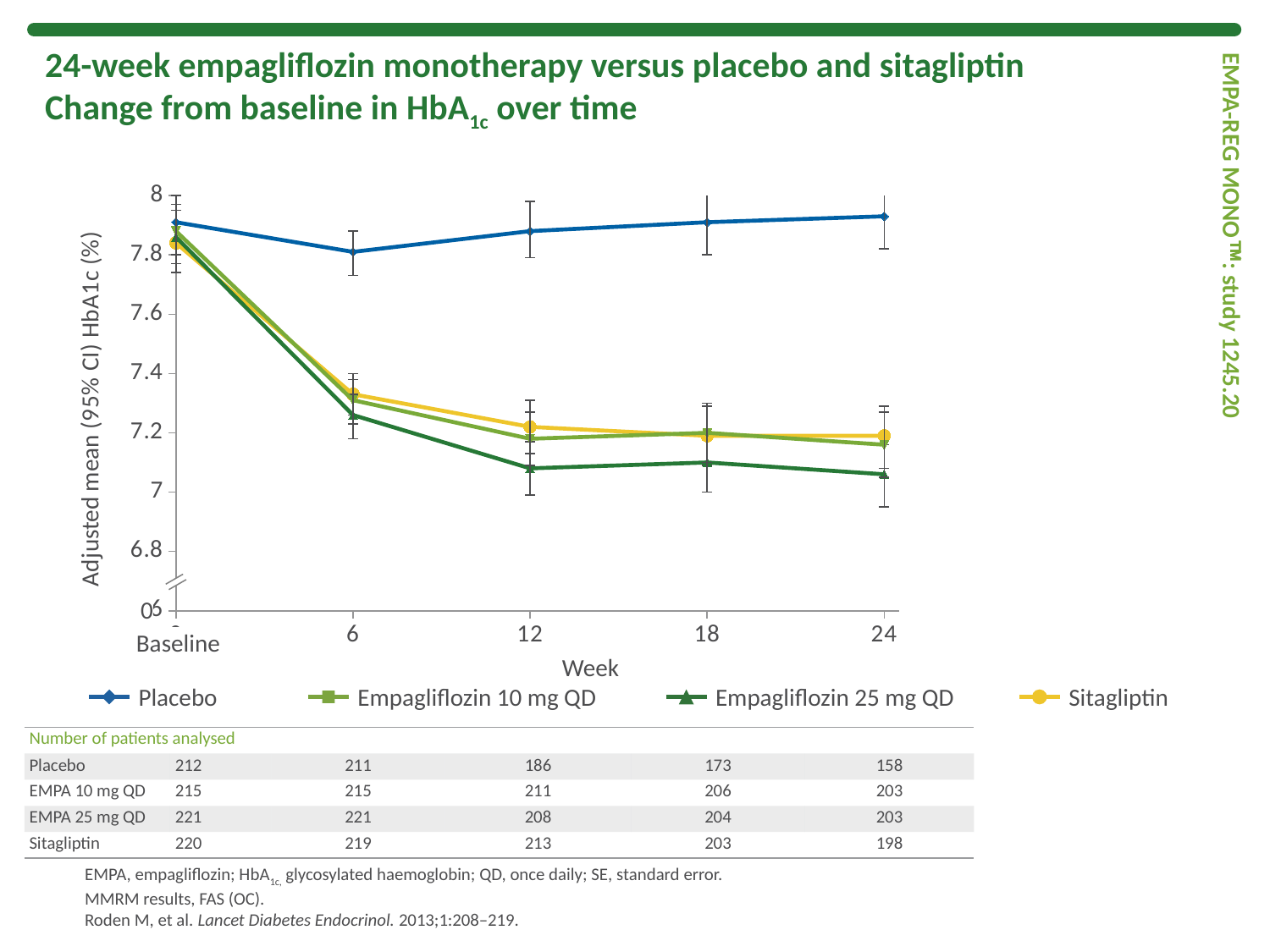
Does the value for Empagliflozin 25 mg QD rise or fall from baseline to week 24? fall At week 18, which is larger: the value for Placebo or the value for Empagliflozin 25 mg QD? Placebo How many series does the legend list? 4 How many time points are plotted along the x axis? 5 What is the label of the y axis? Adjusted mean (95% CI) HbA1c (%) Is the value for Placebo at week 24 greater or less than 7.8? greater Which series has the highest value at week 24? Placebo What kind of chart is shown on the slide? line chart Is the value for Sitagliptin at week 6 greater or less than 7.2? greater Which series has the lowest value at week 24? Empagliflozin 25 mg QD In the 'Number of patients analysed' table below the chart, how many Sitagliptin patients were analysed at week 24? 198 Is the value for Empagliflozin 25 mg QD at week 24 greater or less than 7.2? less